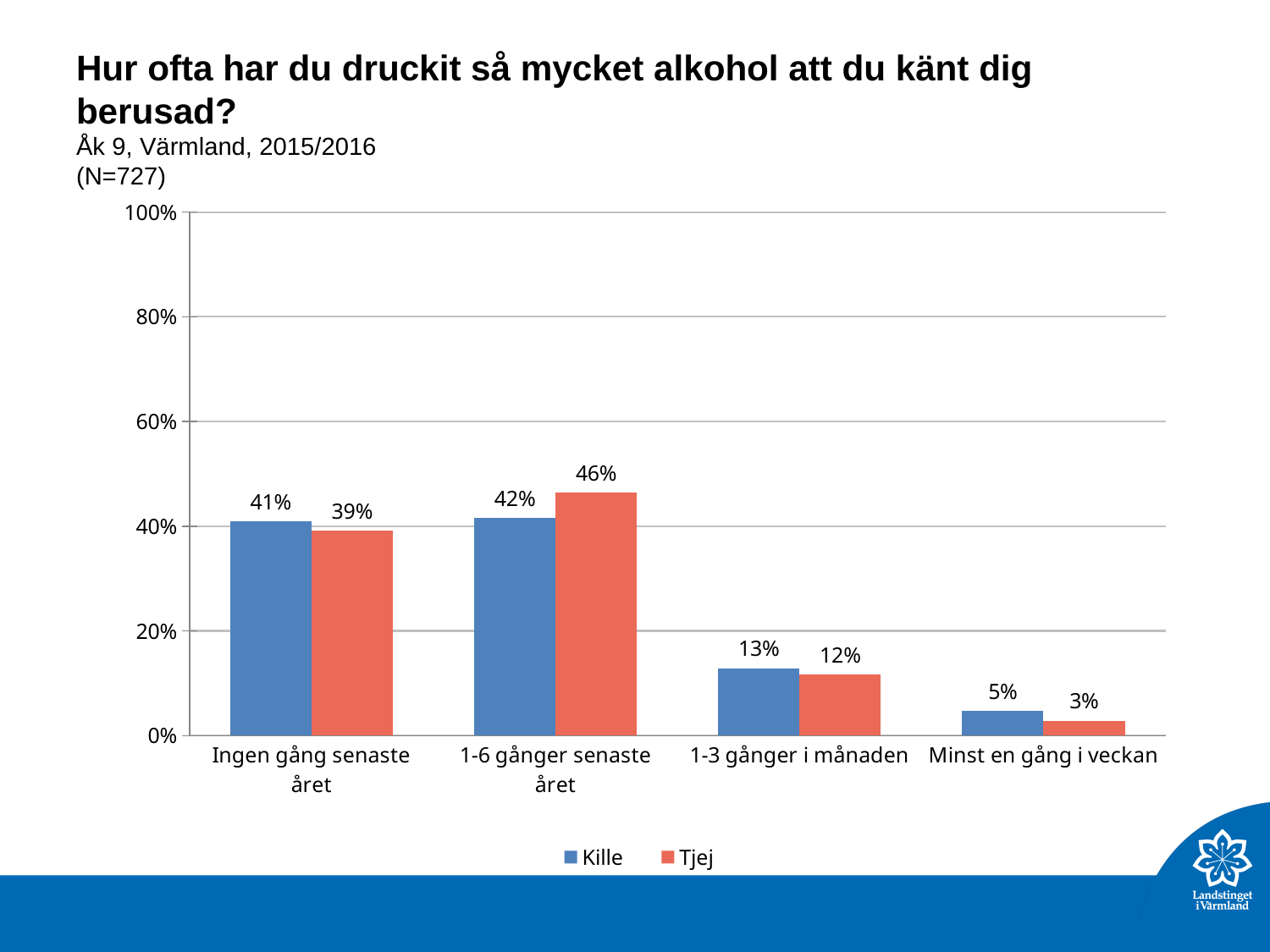
Which category has the highest value for Tjej? 1-6 gånger senaste året What is the value for Tjej in the category 'Minst en gång i veckan'? 3% What are the two series named in the legend? Kille and Tjej What kind of chart is shown on the slide? Bar chart Which is larger in the category 'Ingen gång senaste året', Kille or Tjej? Kille What is the value for Kille in the category '1-3 gånger i månaden'? 13% How many series does the legend list? 2 Which category has the lowest value for Kille? Minst en gång i veckan What is the difference between Tjej and Kille in the category '1-6 gånger senaste året'? 4% What is the value for Kille in the category 'Ingen gång senaste året'? 41% How many categories are shown on the x axis? 4 What is the value for Tjej in the category '1-6 gånger senaste året'? 46%